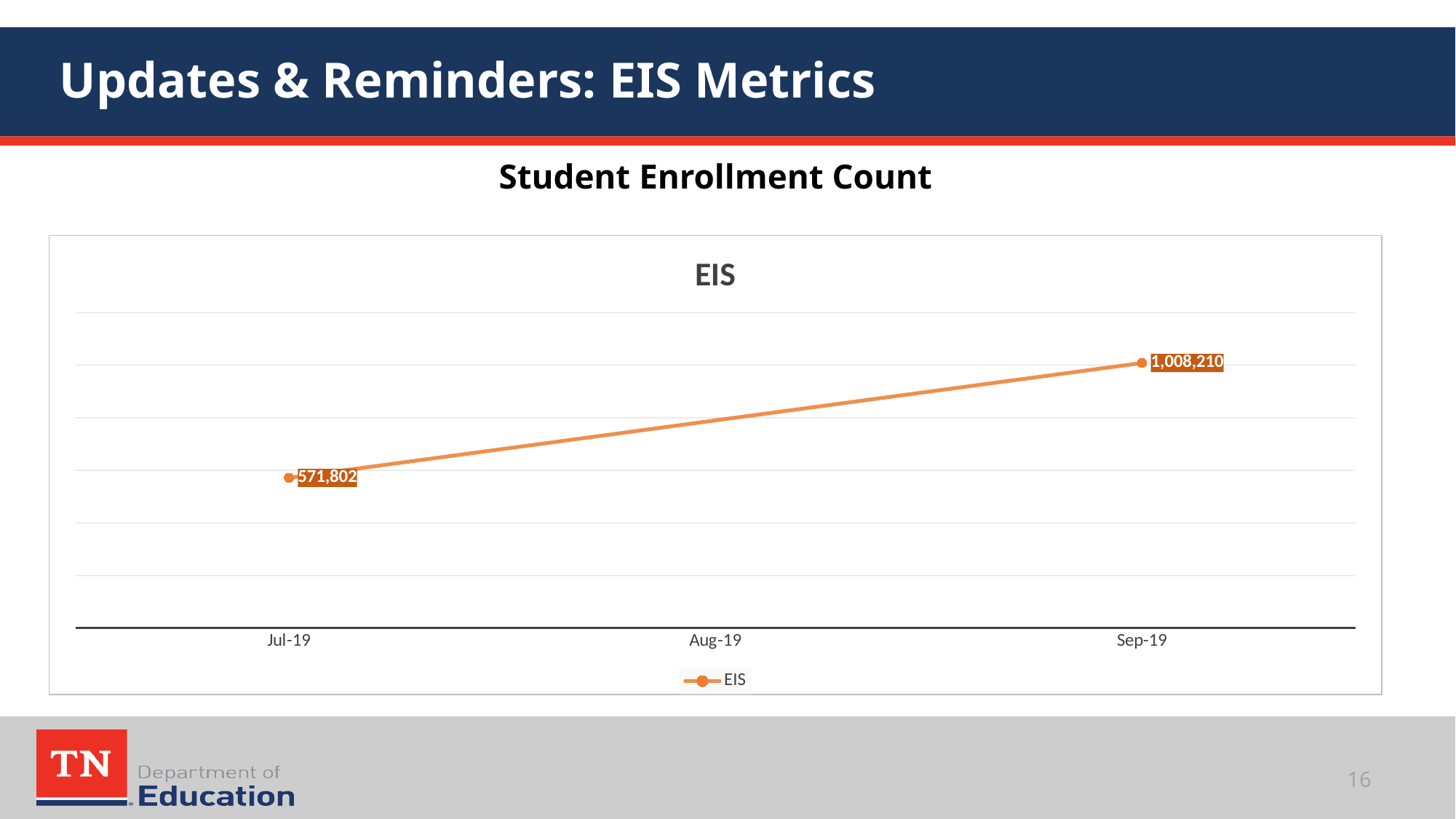
Does the EIS enrollment count rise or fall from Jul-19 to Sep-19? Rise What is the EIS student enrollment count for Sep-19? 1,008,210 Which is larger, the EIS enrollment count for Jul-19 or for Sep-19? Sep-19 Which month has the lowest EIS enrollment count? Jul-19 How many series does the legend list? 1 Which month has the highest EIS enrollment count? Sep-19 How many data points have values labeled on the chart? 2 How many months are labeled on the x axis of the chart? 3 What is the EIS student enrollment count for Jul-19? 571,802 What is the title shown inside the chart area? EIS What kind of chart is shown on the slide? Line chart What is the difference between the Sep-19 and Jul-19 EIS enrollment counts? 436,408